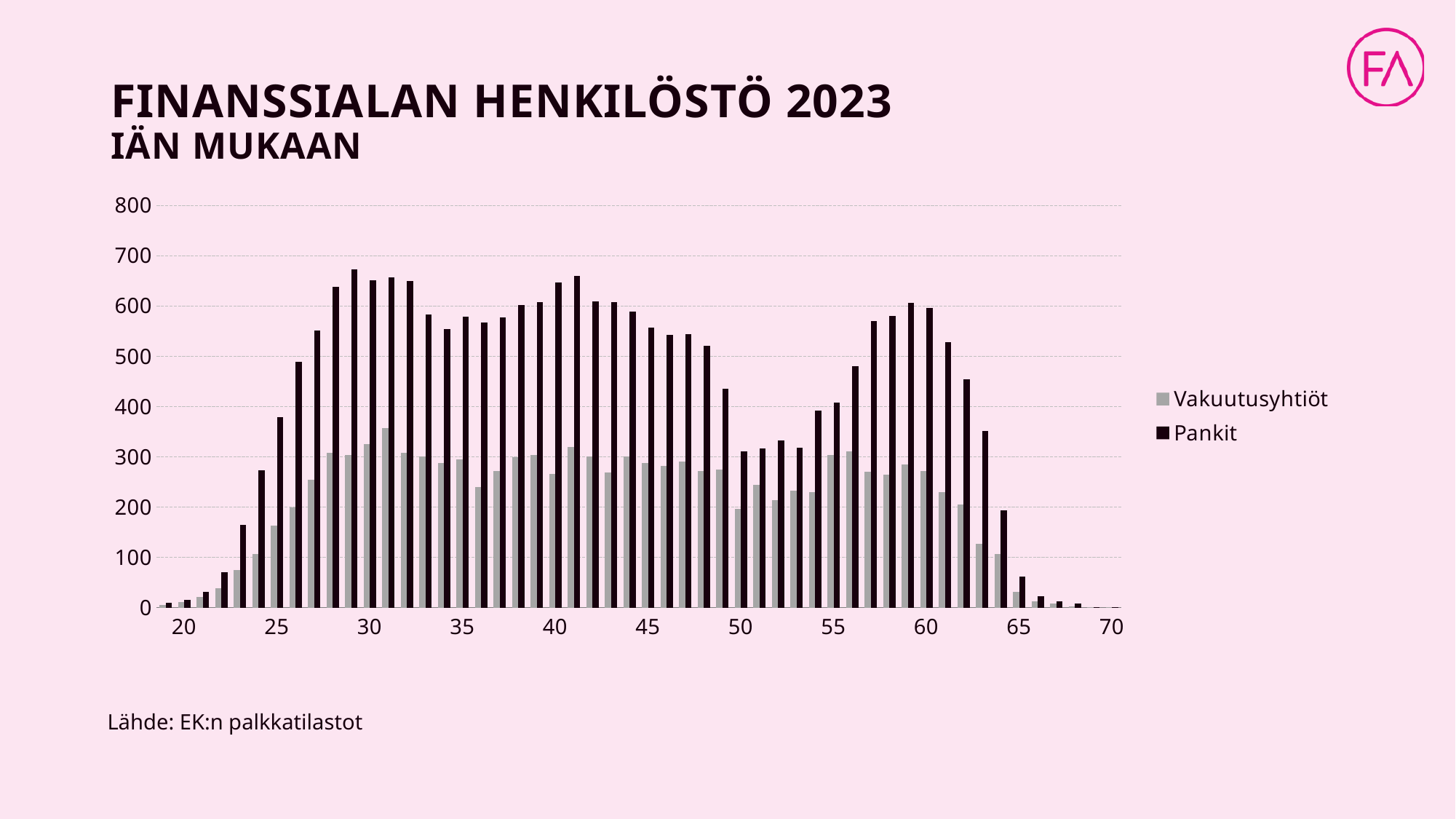
At age 40, which series has the larger value, Pankit or Vakuutusyhtiöt? Pankit Do the Pankit values rise or fall from age 60 to age 70? fall Is the Pankit value at age 60 greater or less than 500? greater Is the Vakuutusyhtiöt value at age 25 greater or less than 200? less What kind of chart is shown on the slide? bar chart Is the Pankit value at age 65 greater or less than 100? less What are the two series named in the legend? Vakuutusyhtiöt and Pankit What is the title of the chart? FINANSSIALAN HENKILÖSTÖ 2023 IÄN MUKAAN At age 55, which series has the larger value, Pankit or Vakuutusyhtiöt? Pankit How many series does the legend list? 2